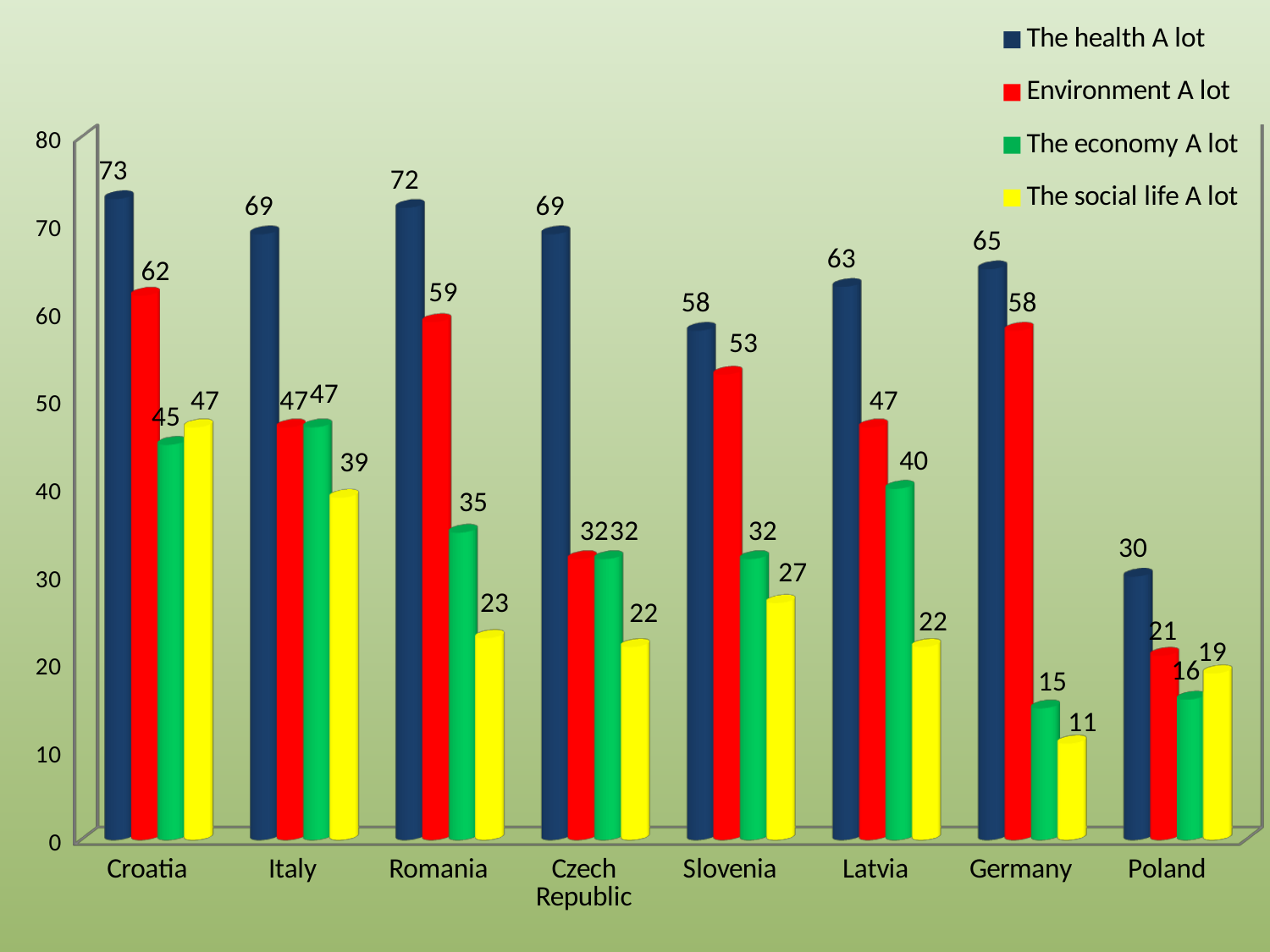
What kind of chart is shown on the slide? Bar chart What is the value for Environment A lot in Romania? 59 What is the value for The economy A lot in Latvia? 40 How many countries are shown on the x axis? 8 Which is larger in Poland: The economy A lot or The social life A lot? The social life A lot What is the difference between The health A lot and Environment A lot in the Czech Republic? 37 What is the value for The health A lot in Croatia? 73 How many series does the legend list? 4 Which colour represents The economy A lot in the legend? Green What is the value for The social life A lot in Germany? 11 Which country has the highest value for The health A lot? Croatia Which country has the lowest value for The health A lot? Poland